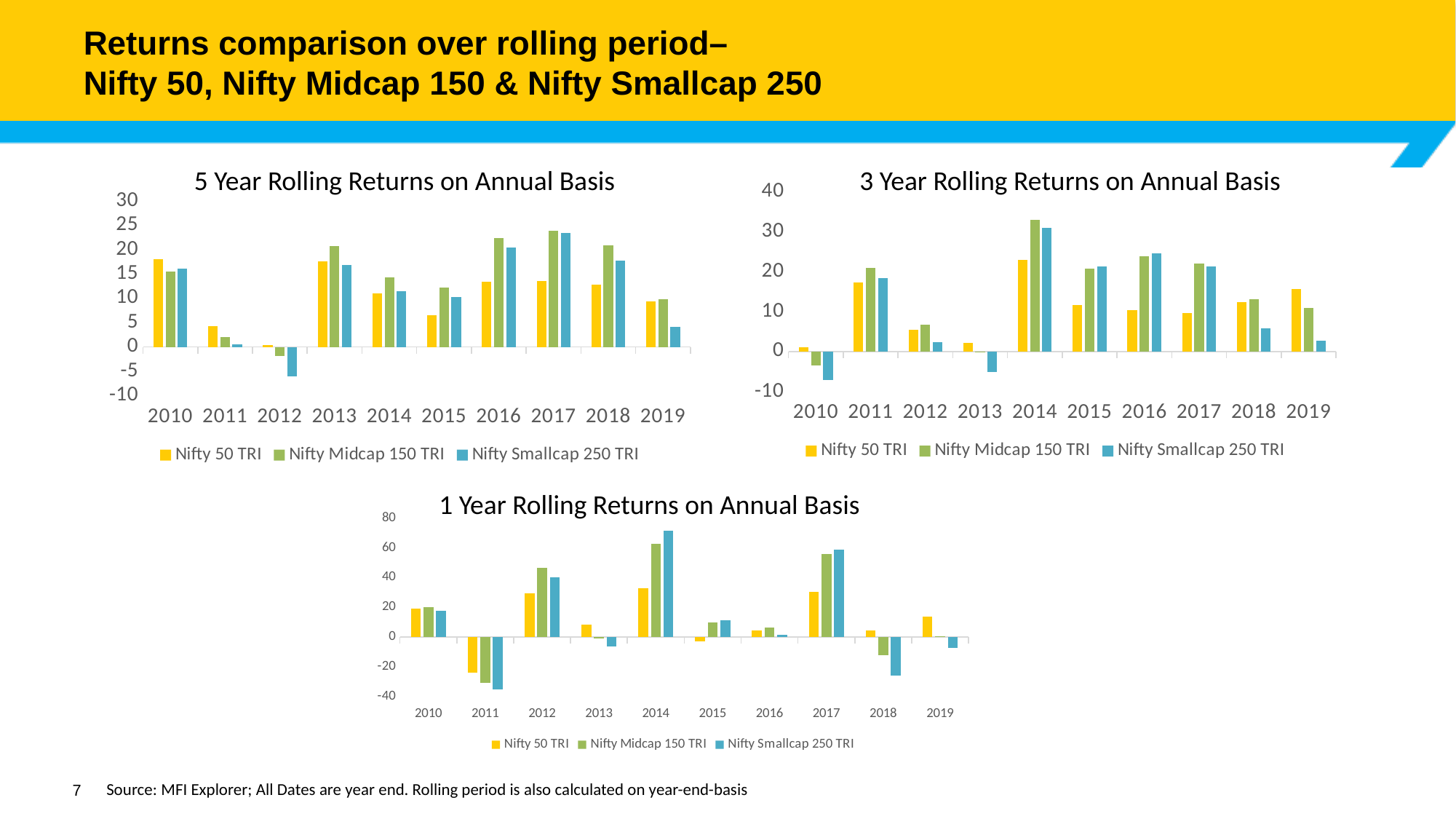
In the '3 Year Rolling Returns on Annual Basis' chart, which is larger in 2011: Nifty 50 TRI or Nifty Midcap 150 TRI? Nifty Midcap 150 TRI In the '1 Year Rolling Returns on Annual Basis' chart, which is larger in 2019: Nifty 50 TRI or Nifty Midcap 150 TRI? Nifty 50 TRI In the '3 Year Rolling Returns on Annual Basis' chart, in which year is the Nifty Midcap 150 TRI value highest? 2014 In the '5 Year Rolling Returns on Annual Basis' chart, is the value for Nifty 50 TRI in 2010 greater or less than 15? greater In the '1 Year Rolling Returns on Annual Basis' chart, in which year is the Nifty Smallcap 250 TRI value lowest? 2011 How many years are shown on the x axis of the '1 Year Rolling Returns on Annual Basis' chart? 10 In the '3 Year Rolling Returns on Annual Basis' chart, is the value for Nifty Midcap 150 TRI in 2014 greater or less than 30? greater In the '5 Year Rolling Returns on Annual Basis' chart, is the value for Nifty Smallcap 250 TRI in 2012 greater or less than 0? less In the '5 Year Rolling Returns on Annual Basis' chart, in which year is the Nifty Smallcap 250 TRI value lowest? 2012 How many series does the legend of the '3 Year Rolling Returns on Annual Basis' chart list? 3 What kind of chart is the '5 Year Rolling Returns on Annual Basis' chart? bar chart